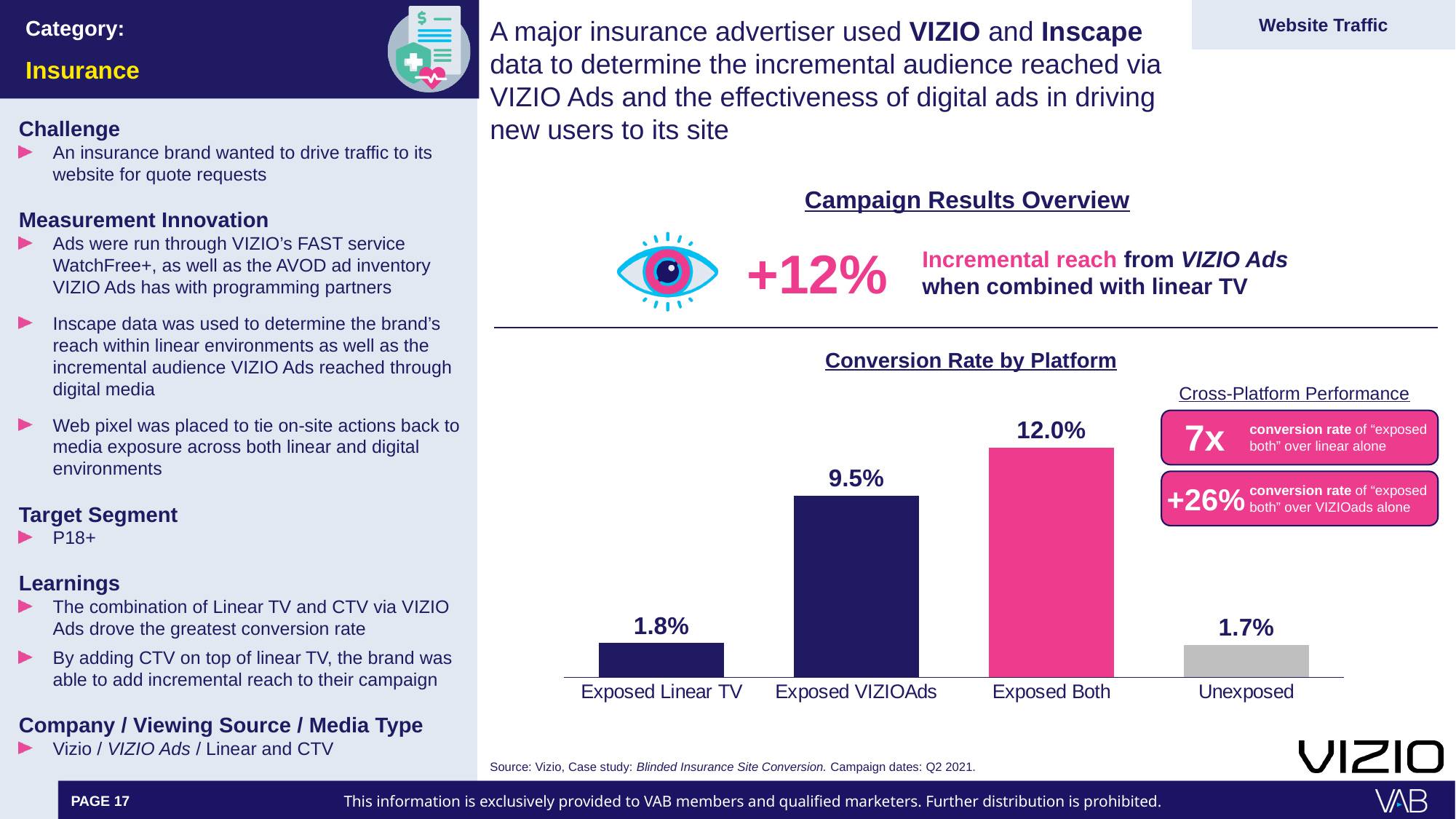
What colour is the Exposed Both bar in the Conversion Rate by Platform chart? Pink How many categories are shown in the Conversion Rate by Platform chart? 4 What is the conversion rate for Exposed VIZIOAds? 9.5% Which has a higher conversion rate, Exposed VIZIOAds or Exposed Linear TV? Exposed VIZIOAds What is the conversion rate for the Unexposed group? 1.7% What is the difference in conversion rate between Exposed Linear TV and Unexposed? 0.1% What type of chart is the Conversion Rate by Platform chart? Bar chart What is the conversion rate for Exposed Linear TV? 1.8% What is the difference in conversion rate between Exposed Both and Exposed VIZIOAds? 2.5% What is the conversion rate for Exposed Both in the Conversion Rate by Platform chart? 12.0% Which platform has the highest conversion rate? Exposed Both Which category has the lowest conversion rate? Unexposed